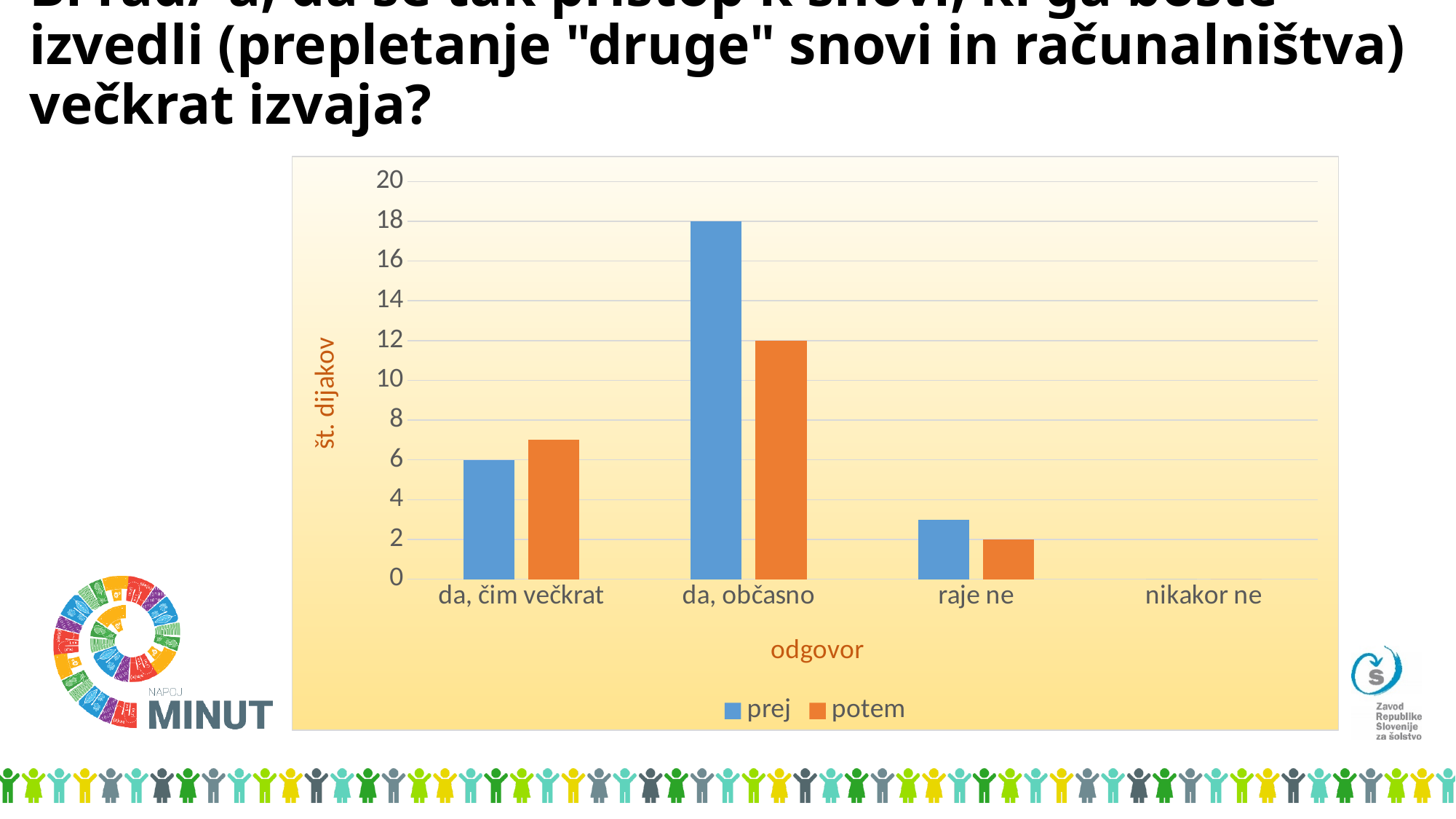
For 'da, občasno', which series has the larger value, 'prej' or 'potem'? prej What is the value of the 'prej' series for 'da, občasno'? 18 What is the value of the 'prej' series for 'da, čim večkrat'? 6 How many series does the legend list? 2 What is the value of the 'potem' series for 'raje ne'? 2 What is the value of the 'potem' series for 'da, občasno'? 12 Which category has the highest value in the 'prej' series? da, občasno What is the title of the vertical axis? št. dijakov What is the difference between the 'prej' and 'potem' values for 'da, občasno'? 6 How many answer categories are shown on the x axis? 4 Is the 'prej' value for 'raje ne' greater or less than 4? less Is the 'potem' value for 'da, čim večkrat' greater or less than 8? less